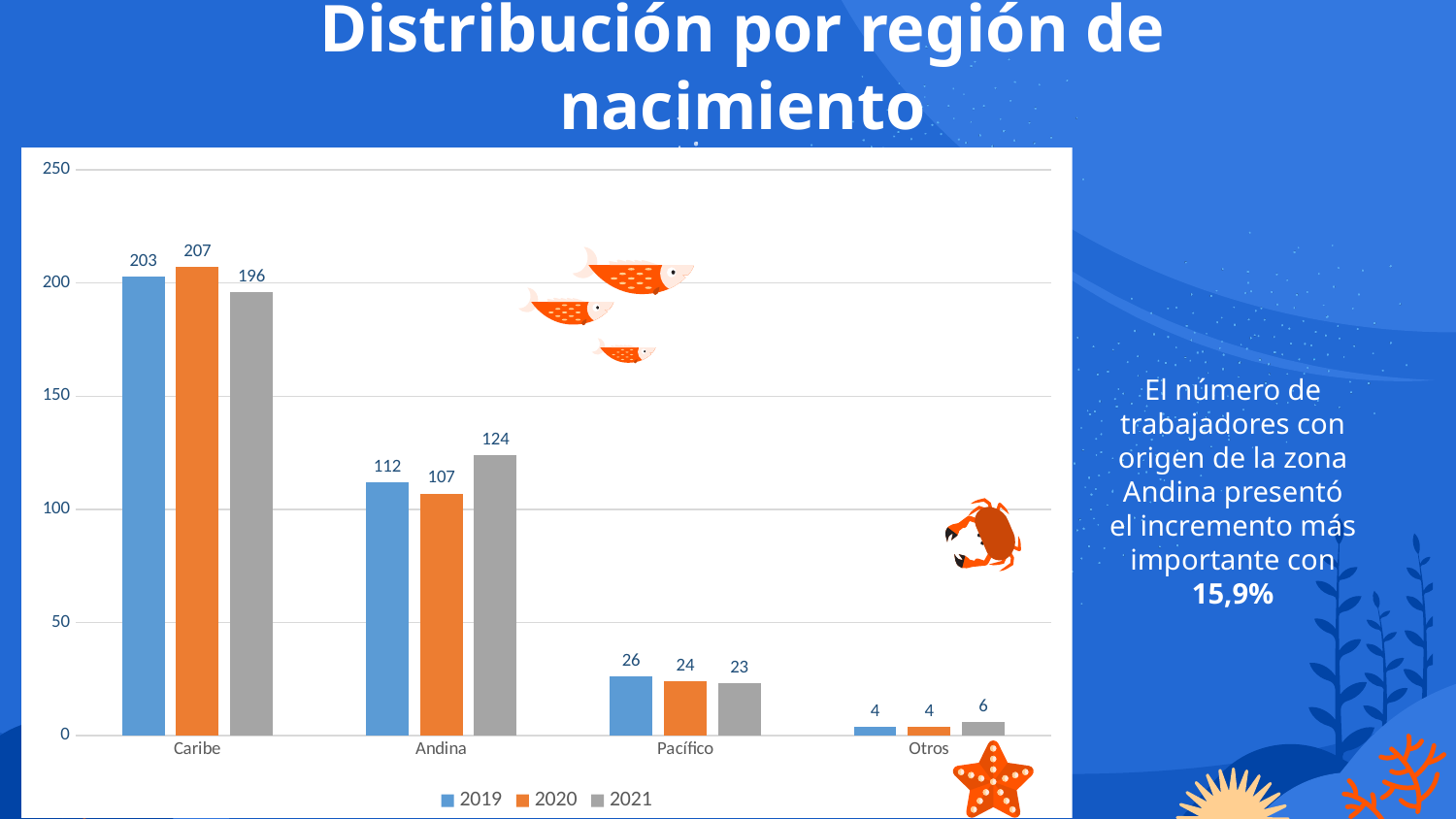
How many regions are shown on the x axis? 4 What is the value for Andina in 2021? 124 Is the value for Andina in 2019 greater or less than 100? greater What is the value for Caribe in 2020? 207 Which region has the lowest value in 2019? Otros What is the title of the slide? Distribución por región de nacimiento What is the value for Pacífico in 2019? 26 What is the difference between the 2021 and 2020 values for Andina? 17 Which is larger for Caribe: the 2019 value or the 2021 value? 2019 Which region has the highest value in 2021? Caribe What kind of chart is shown on the slide? Bar chart How many series does the legend list? 3